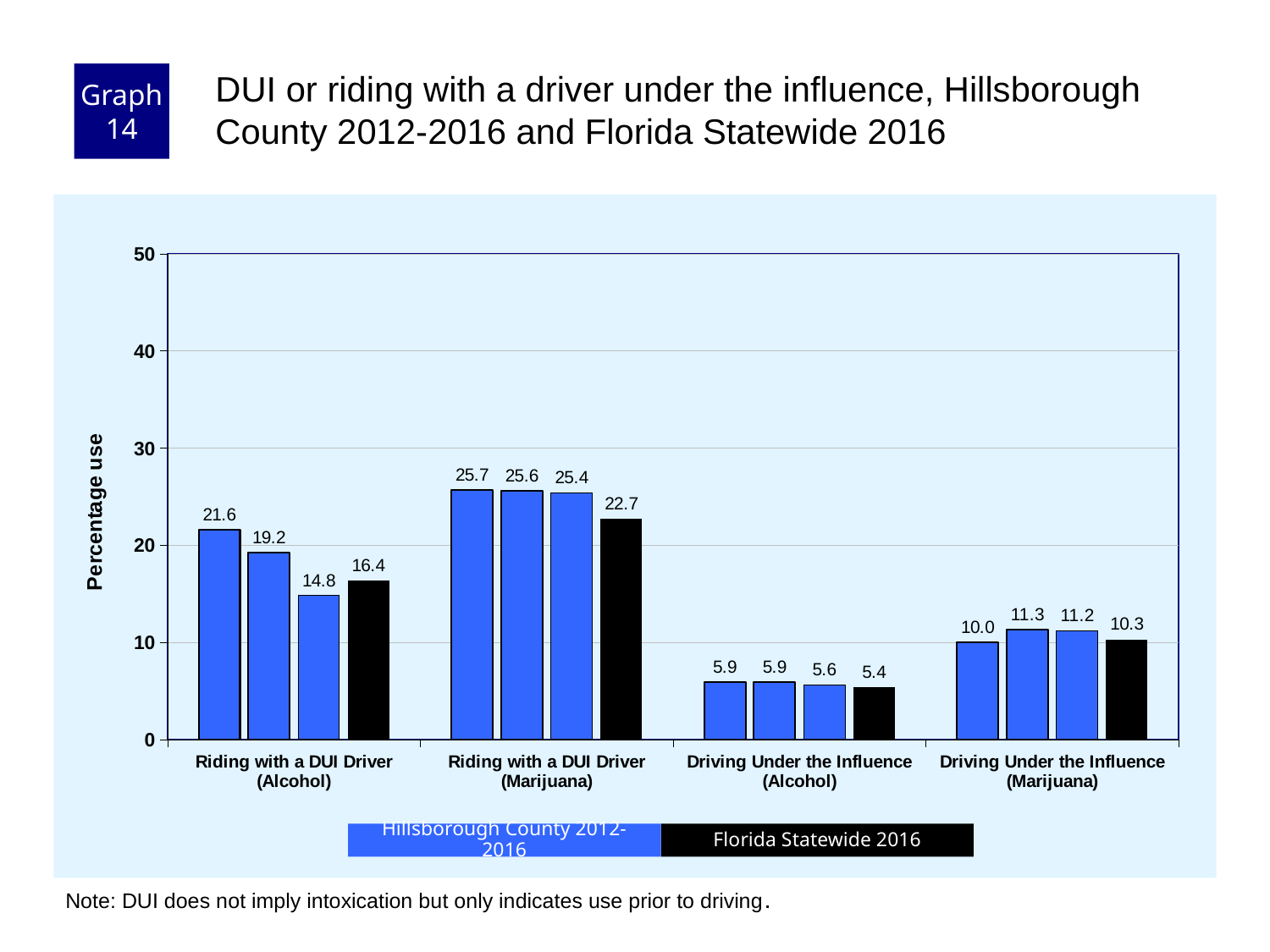
What kind of chart is shown on the slide? bar chart How many categories are shown on the x axis? 4 What is the Florida Statewide 2016 value for Riding with a DUI Driver (Alcohol)? 16.4 What is the difference between the Florida Statewide 2016 values for Riding with a DUI Driver (Marijuana) and Riding with a DUI Driver (Alcohol)? 6.3 What is the lowest value shown on the chart? 5.4 Which category has the highest bar on the chart? Riding with a DUI Driver (Marijuana) What is the value of the first (leftmost) Hillsborough County bar for Riding with a DUI Driver (Alcohol)? 21.6 What is the label on the y axis? Percentage use Is the Florida Statewide 2016 value for Riding with a DUI Driver (Marijuana) greater or less than 20? greater How many series does the legend list? 2 What is the Florida Statewide 2016 value for Driving Under the Influence (Marijuana)? 10.3 For Florida Statewide 2016, which is larger: Riding with a DUI Driver (Alcohol) or Driving Under the Influence (Marijuana)? Riding with a DUI Driver (Alcohol)